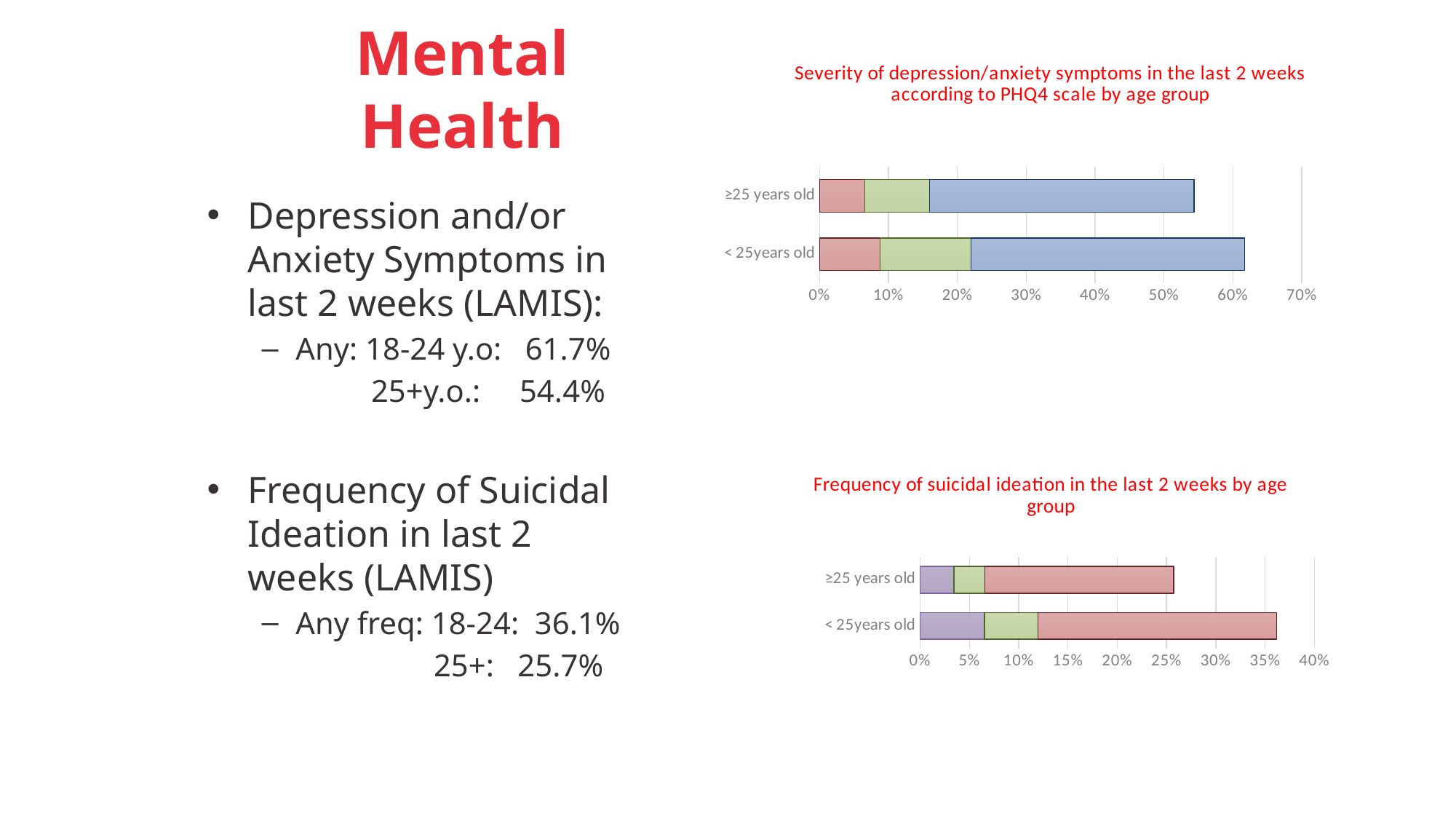
In the bottom chart on frequency of suicidal ideation, what is the highest value shown on the horizontal axis? 40% In the bottom chart on frequency of suicidal ideation, is the total bar for ≥25 years old greater or less than 30%? less In the bottom chart on frequency of suicidal ideation, which age group has the longer total bar? < 25years old In the top chart on severity of depression/anxiety symptoms, what is the highest value shown on the horizontal axis? 70% In the top chart on severity of depression/anxiety symptoms, is the total bar for ≥25 years old greater or less than 50%? greater In the bottom chart on frequency of suicidal ideation, how many coloured segments make up each bar? 3 In the top chart on severity of depression/anxiety symptoms, how many age-group categories are shown? 2 What kind of chart is the bottom chart, 'Frequency of suicidal ideation in the last 2 weeks by age group'? Stacked bar chart In the top chart on severity of depression/anxiety symptoms, which age group has the longer total bar? < 25years old In the top chart on severity of depression/anxiety symptoms, is the total bar for < 25years old greater or less than 60%? greater What kind of chart is the top chart, 'Severity of depression/anxiety symptoms in the last 2 weeks according to PHQ4 scale by age group'? Stacked bar chart